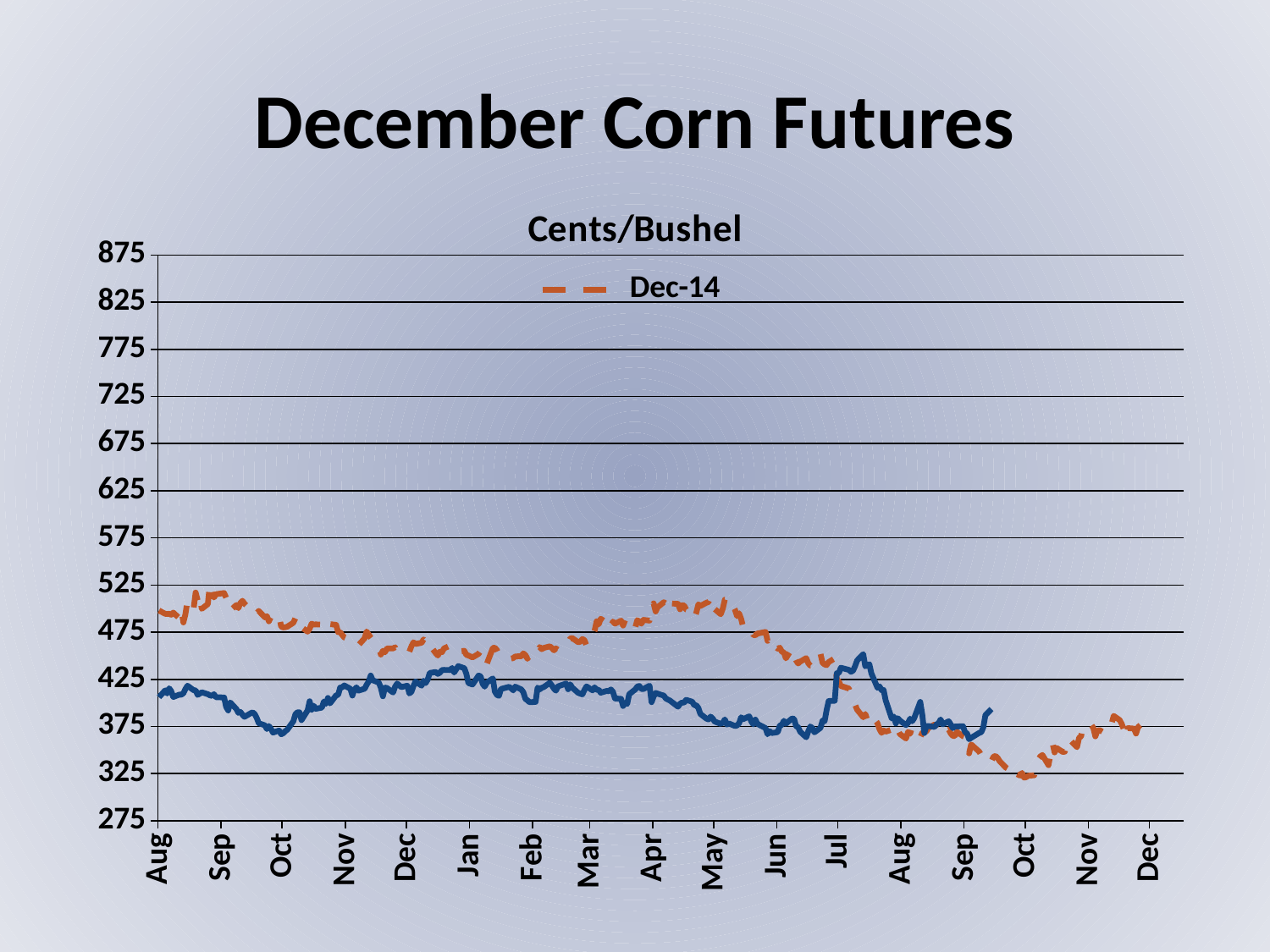
What is the title printed above the chart's plot area? Cents/Bushel Around which x-axis label does the Dec-14 series reach its lowest point? Oct (the second Oct) Is the Dec-14 value at the Jan label greater or less than 475? less What is the name of the series listed in the legend? Dec-14 Is the Dec-14 value higher at the first Sep label or at the second Oct label? Sep Overall, does the Dec-14 series rise or fall from the first Aug label to the final Dec label? fall Is the Dec-14 value at the first Sep label greater or less than 475? greater Is the Dec-14 value at the Apr label greater or less than 475? greater How many series does the chart's legend list? 1 How many month labels are shown along the x axis? 17 What kind of chart is shown on the slide? line chart